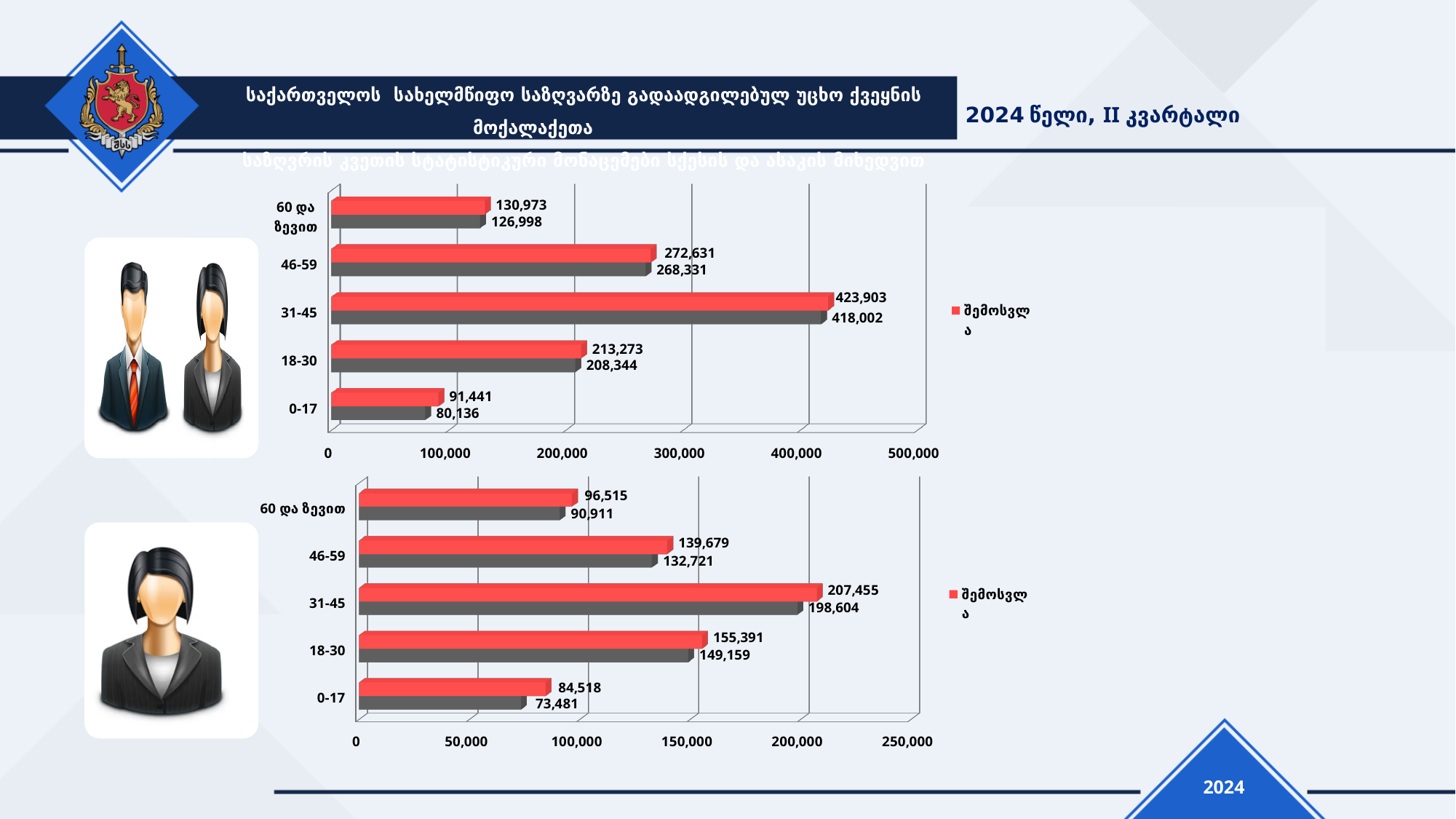
In the bottom chart, which age group has the lowest grey-bar value? 0-17 What type of chart is the bottom chart? bar chart In the top chart, what is the difference between the red and grey values for the 46-59 age group? 4,300 In the top chart, what is the value of the grey bar for the 18-30 age group? 208,344 In the bottom chart, what is the difference between the red and grey values for the 31-45 age group? 8,851 In the bottom chart, what is the value of the grey bar for the 0-17 age group? 73,481 In the top chart, what is the value of the red bar for the 31-45 age group? 423,903 In the top chart, which has the larger red-bar value: 18-30 or 60 და ზევით? 18-30 In the top chart, which age group has the highest red-bar value? 31-45 What colour is the series labelled "შემოსვლა" in the legend of the top chart? red In the bottom chart, is the red-bar value for the 18-30 age group greater or less than 150,000? greater How many age-group categories are shown in the top chart? 5